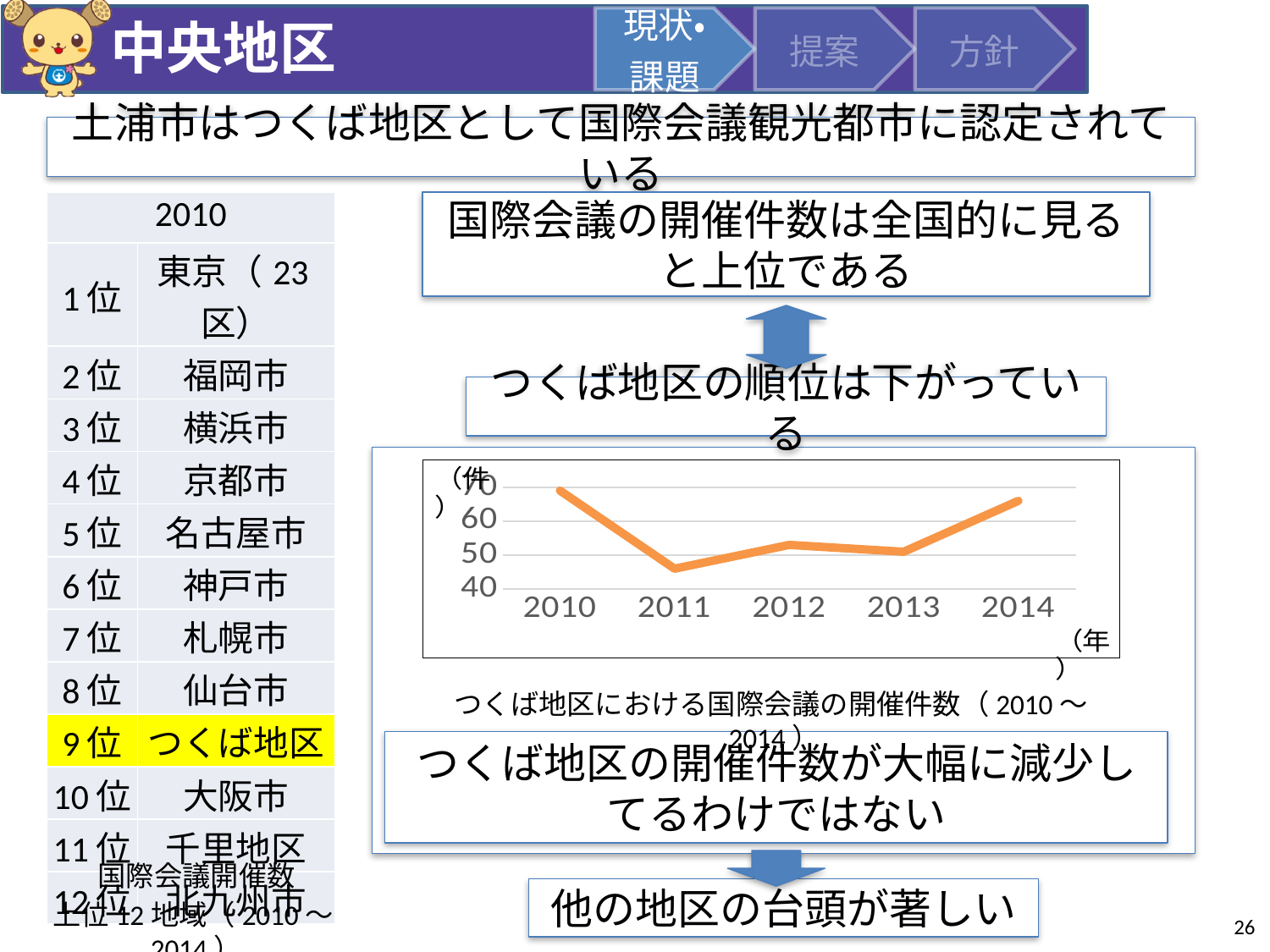
Does the value rise or fall from 2010 to 2011? fall Is the value for 2012 greater or less than 50? greater Is the value for 2013 greater or less than 60? less What kind of chart is shown on the slide? line chart Which is larger, the value for 2011 or the value for 2012? 2012 How many years are plotted on the x axis of the line chart? 5 Is the value for 2011 greater or less than 50? less Which year has the highest value in the line chart? 2010 Does the value rise or fall from 2013 to 2014? rise Which year has the lowest value in the line chart? 2011 What unit is shown on the vertical axis of the line chart? 件